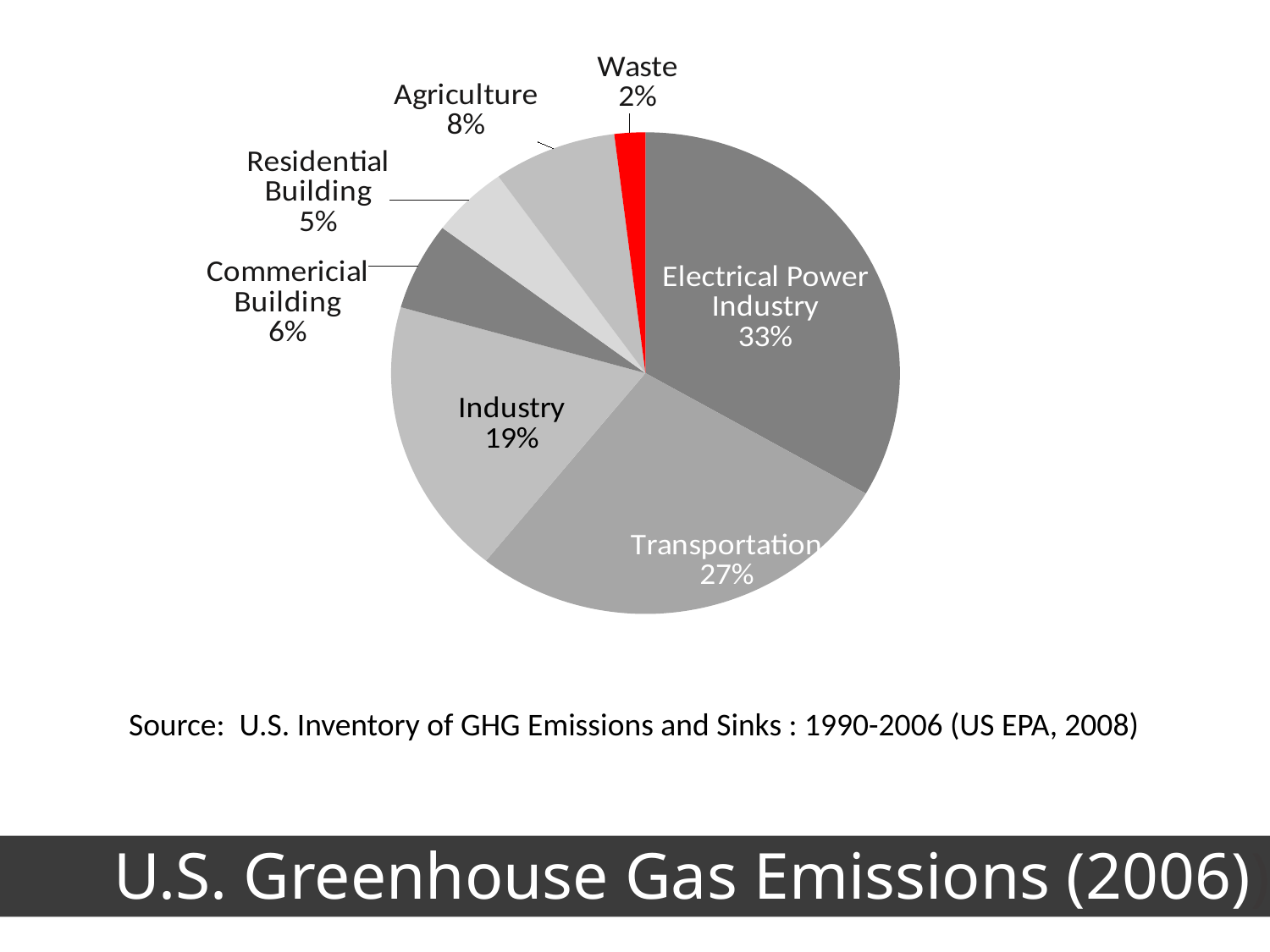
What share of U.S. greenhouse gas emissions comes from the Electrical Power Industry? 33% Which category has the largest share of emissions? Electrical Power Industry What percentage of emissions is attributed to Transportation? 27% Which category has the smallest share of emissions? Waste What is the difference in percentage points between Electrical Power Industry and Transportation? 6 How many categories are shown in the pie chart? 7 What percentage does Agriculture account for? 8% What is the share for Residential Building? 5% Which is larger, the share for Commericial Building or Residential Building? Commericial Building Which slice of the pie is coloured red? Waste What is the share for Industry? 19% What type of chart is shown on the slide? Pie chart